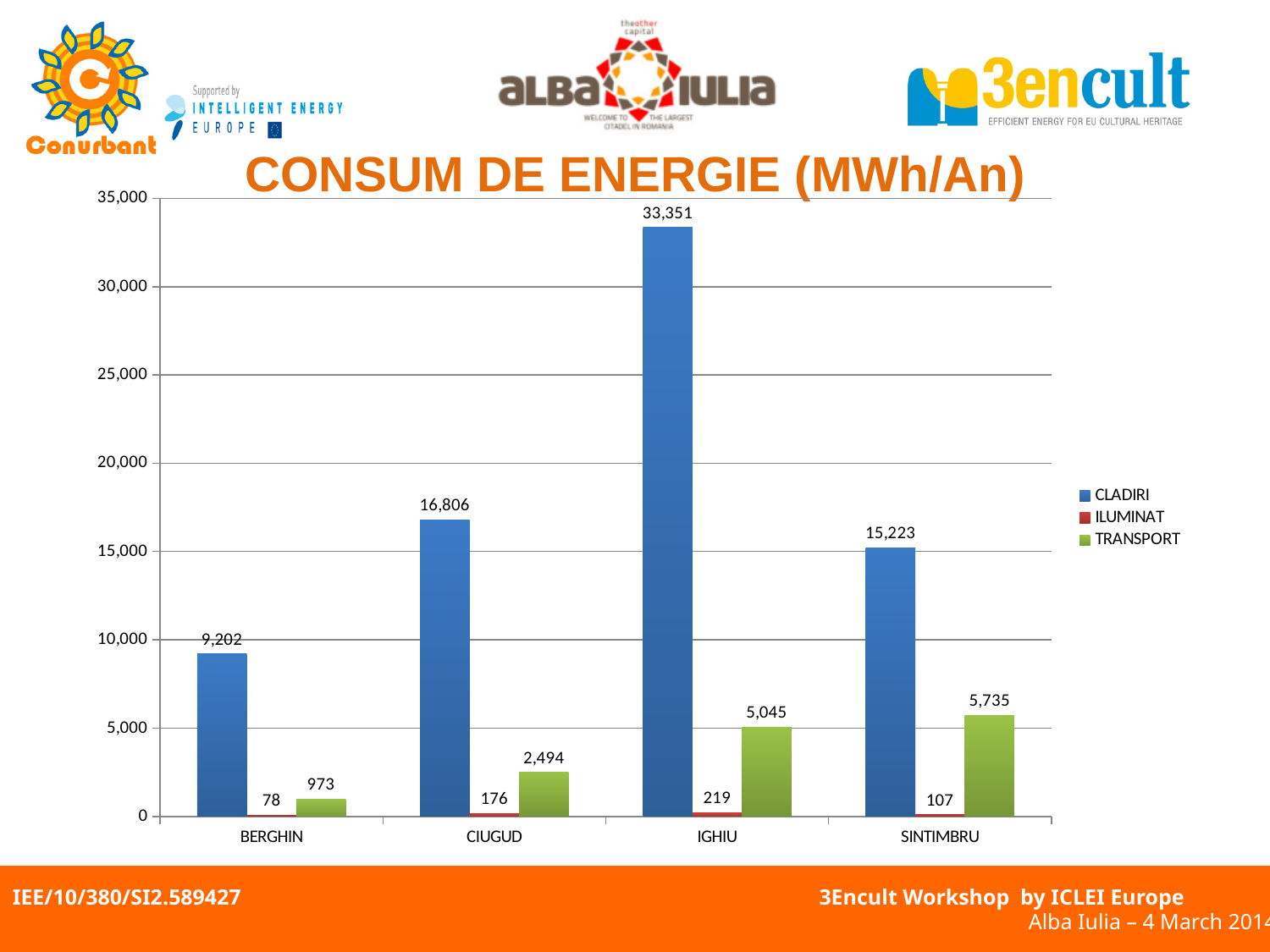
What is the CLADIRI value for IGHIU? 33,351 What is the TRANSPORT value for SINTIMBRU? 5,735 Which category has the highest CLADIRI value? IGHIU What is the title of the chart? CONSUM DE ENERGIE (MWh/An) Which category has the lowest ILUMINAT value? BERGHIN What is the difference between the CLADIRI values for CIUGUD and SINTIMBRU? 1,583 What kind of chart is shown on the slide? bar chart What is the total of the three series for BERGHIN? 10,253 How many categories are shown on the x axis? 4 What is the ILUMINAT value for CIUGUD? 176 Which is larger, the TRANSPORT value for IGHIU or the TRANSPORT value for SINTIMBRU? SINTIMBRU How many series does the legend list? 3